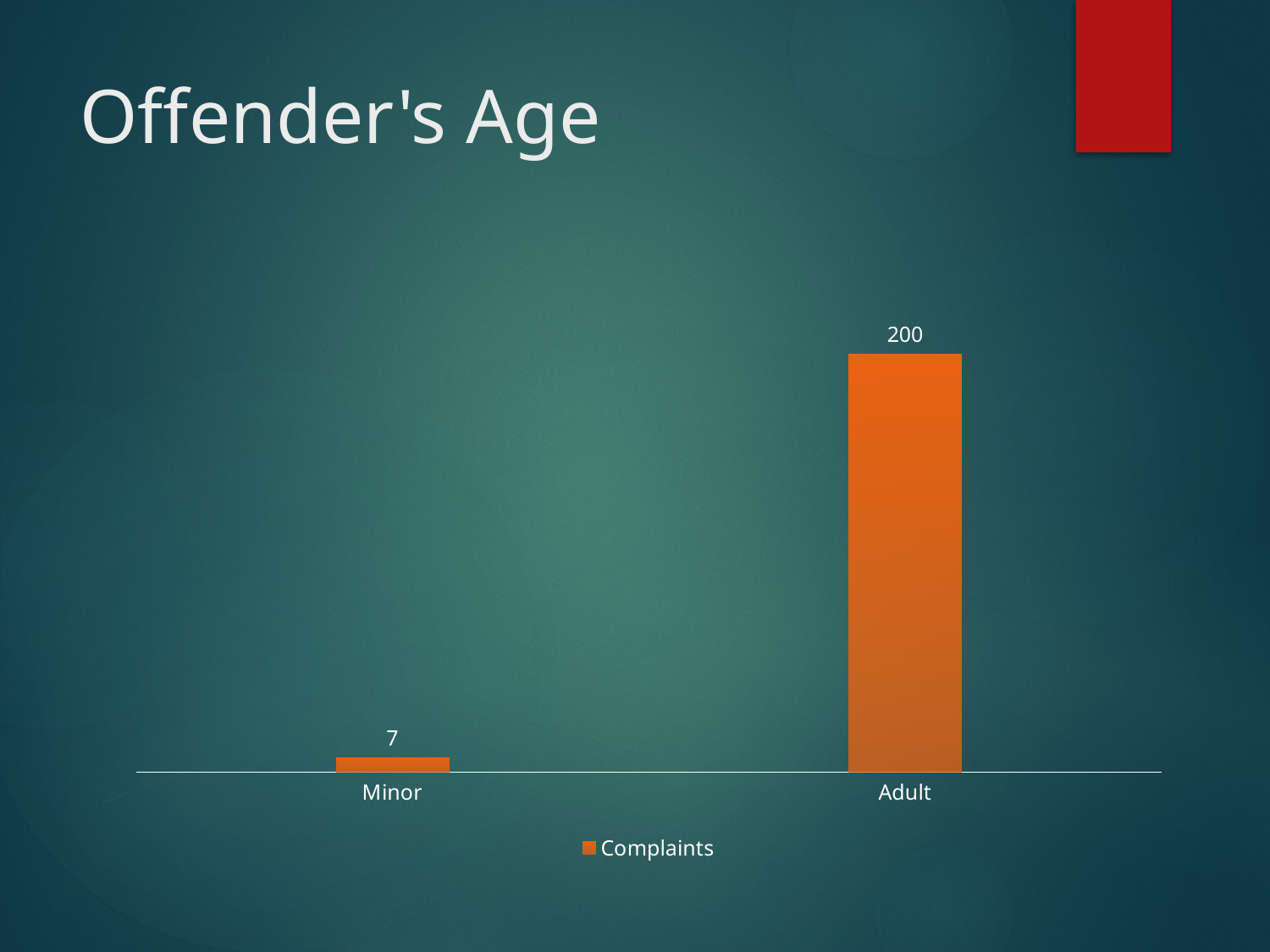
How many categories are shown on the x axis? 2 Which category has the lowest number of complaints? Minor What is the difference in complaints between Adult and Minor offenders? 193 What series name is shown in the legend? Complaints How many series does the legend list? 1 What is the title of the slide? Offender's Age What is the number of complaints for Adult offenders? 200 Which category has the highest number of complaints? Adult Which has more complaints, Minor or Adult? Adult What kind of chart is shown on the slide? Bar chart What is the number of complaints for Minor offenders? 7 What is the total number of complaints across both categories? 207